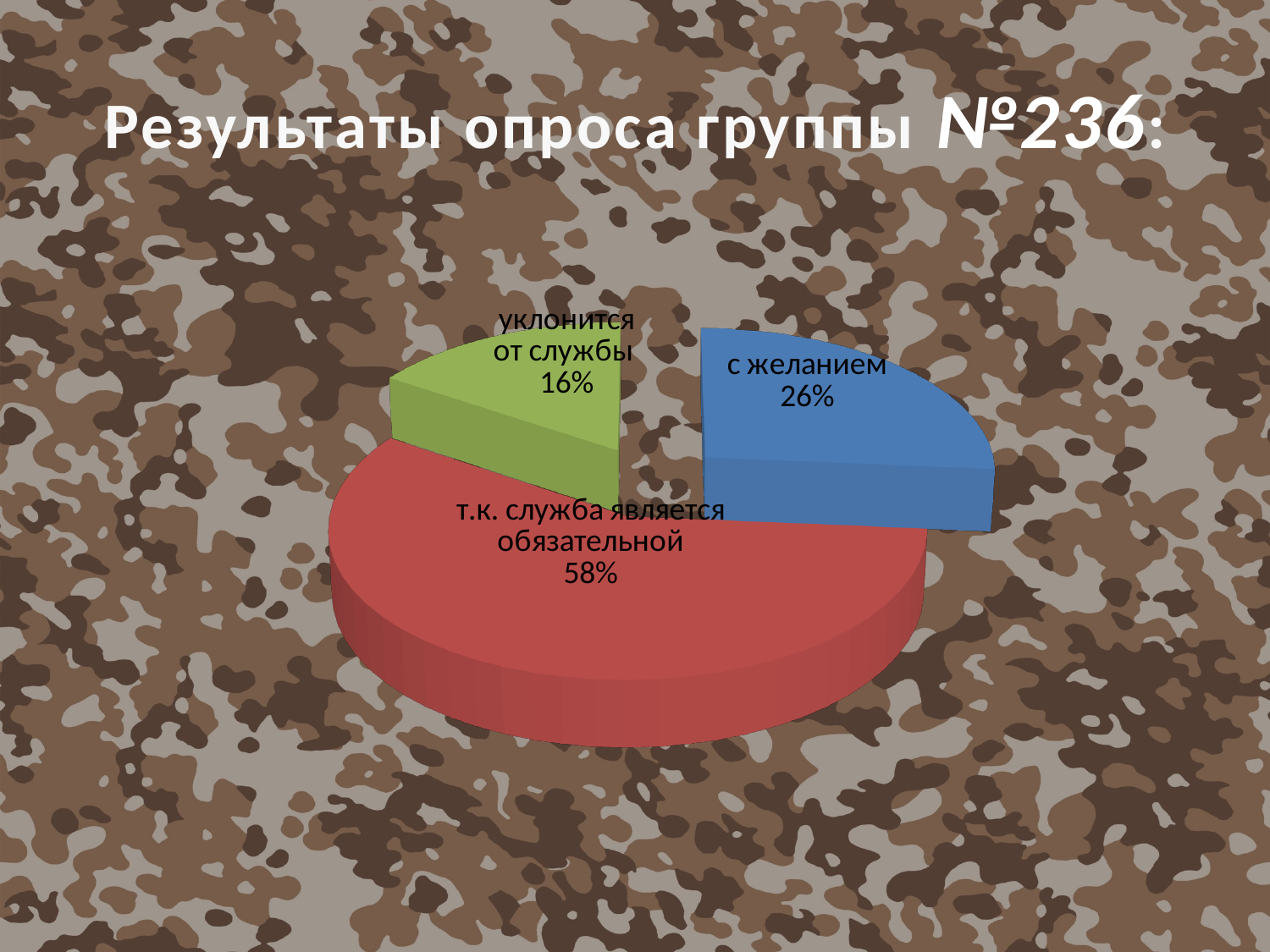
What kind of chart is shown on the slide? pie chart What is the difference in percentage points between the "т.к. служба является обязательной" slice and the "с желанием" slice? 32 Which slice of the pie is the smallest? уклонится от службы What share of the pie does the slice "уклонится от службы" represent? 16% What is the difference in percentage points between the "с желанием" slice and the "уклонится от службы" slice? 10 What share of the pie does the slice "с желанием" represent? 26% What colour is the slice labelled "с желанием"? blue What share of the pie does the slice "т.к. служба является обязательной" represent? 58% What is the title of the slide containing the pie chart? Результаты опроса группы №236: Which slice of the pie is the largest? т.к. служба является обязательной Which slice is larger: "с желанием" or "уклонится от службы"? с желанием How many slices does the pie chart have? 3